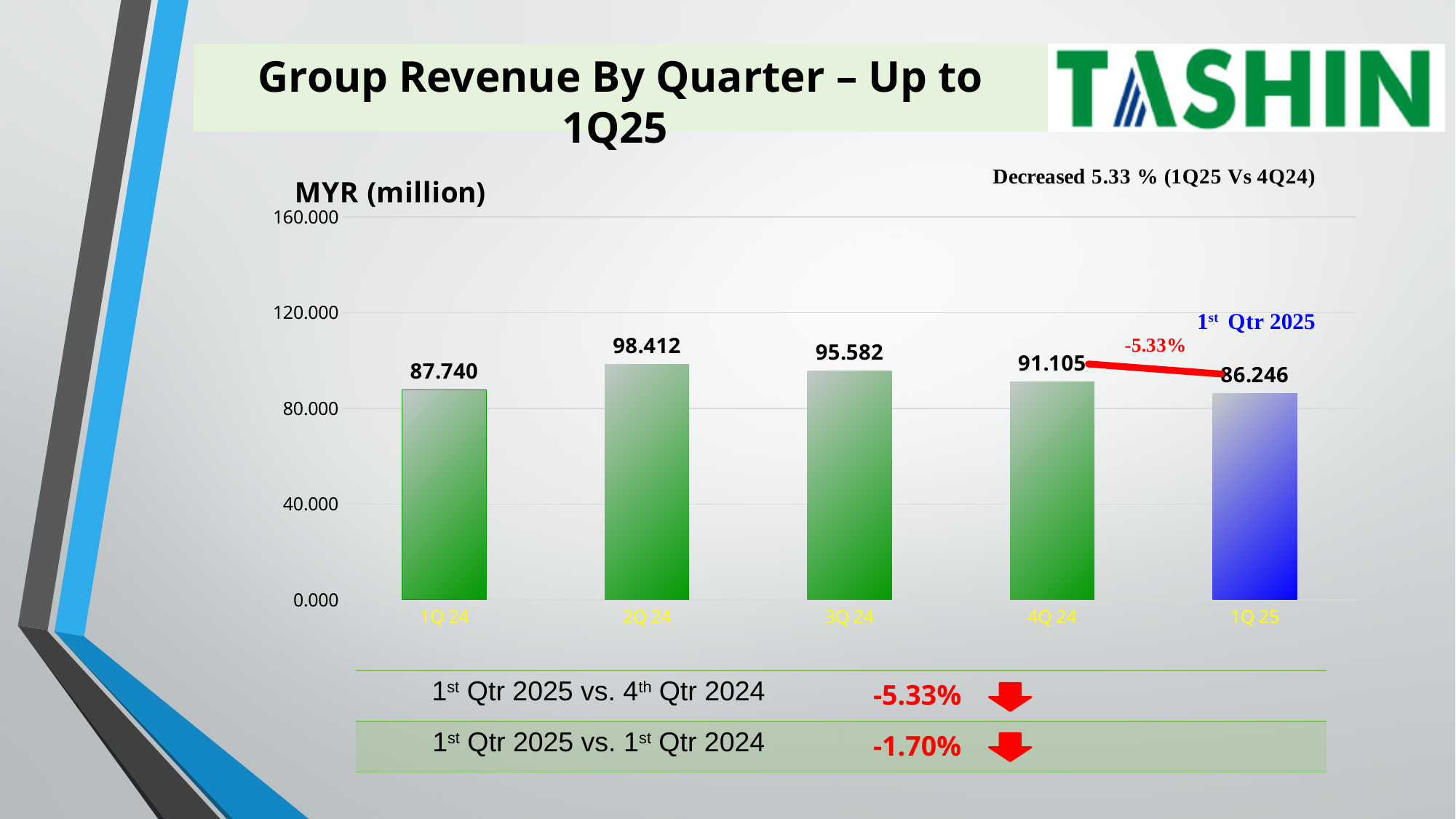
Which quarter has higher group revenue, 1Q 24 or 3Q 24? 3Q 24 What kind of chart is shown on the slide? Bar chart Which quarter has the highest group revenue? 2Q 24 What unit is shown on the chart's axis label? MYR (million) How many quarters are shown on the chart? 5 What is the group revenue for 2Q 24? 98.412 Which quarter has the lowest group revenue? 1Q 25 Is the group revenue for 3Q 24 greater or less than 80.000? greater What is the group revenue for 4Q 24? 91.105 What is the percentage change in group revenue from 4Q 24 to 1Q 25 shown on the chart? -5.33% What is the difference in group revenue between 4Q 24 and 1Q 25? 4.859 What is the group revenue for 1Q 25? 86.246